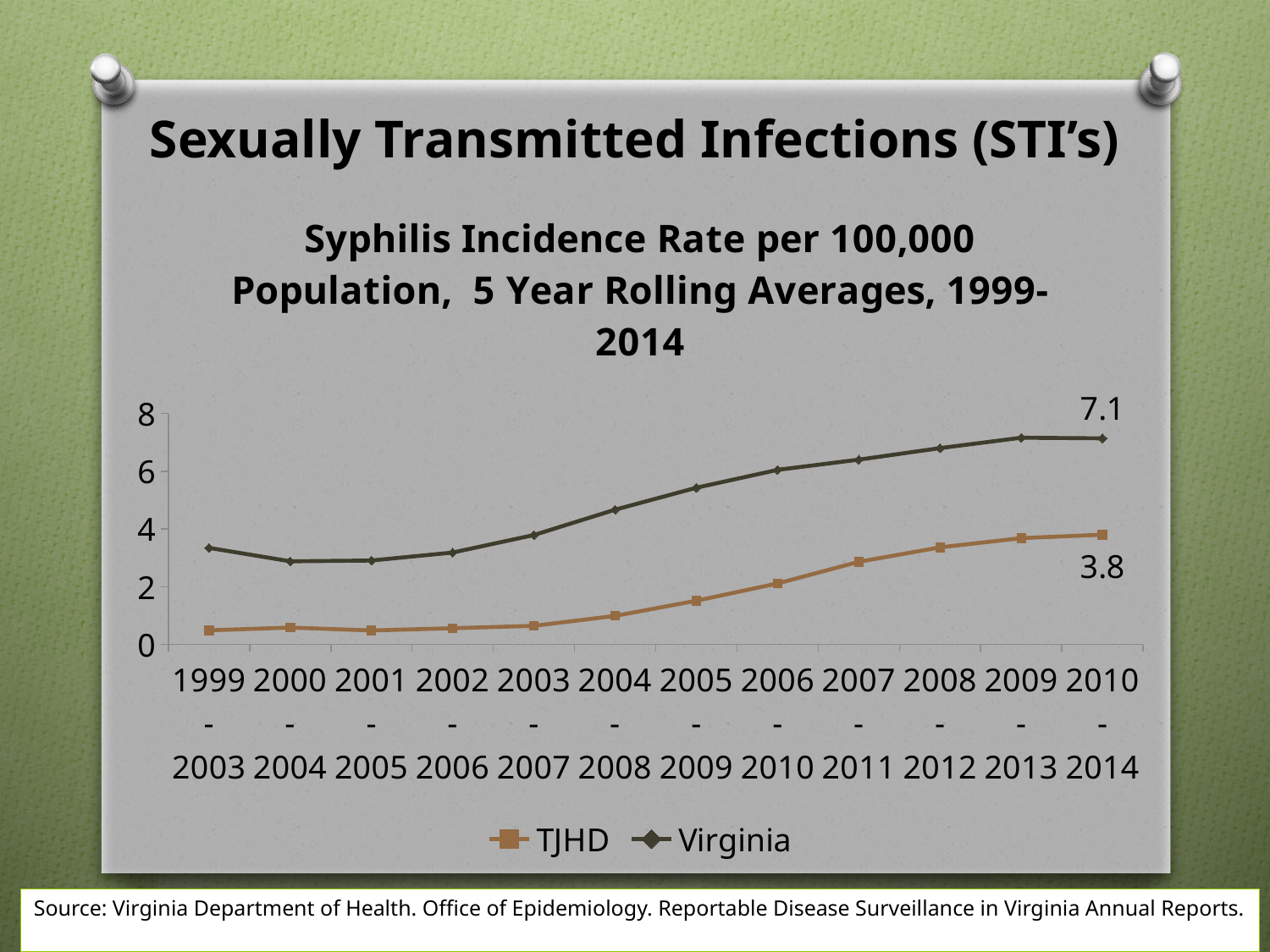
Does the TJHD series rise or fall overall from 1999-2003 to 2010-2014? Rise Which series has the higher value for the 2010-2014 period, TJHD or Virginia? Virginia Is the Virginia value for 2004-2008 greater or less than 4? greater What is the Virginia syphilis incidence rate for the 2010-2014 period? 7.1 What kind of chart is shown on the slide? Line chart What is the difference between the Virginia and TJHD rates for the 2010-2014 period? 3.3 Is the TJHD value for 2005-2009 greater or less than 2? less Is the Virginia value for 1999-2003 greater or less than 4? less What are the two series named in the legend? TJHD and Virginia What is the TJHD syphilis incidence rate for the 2010-2014 period? 3.8 How many series does the legend list? 2 How many time periods are plotted along the x axis? 12